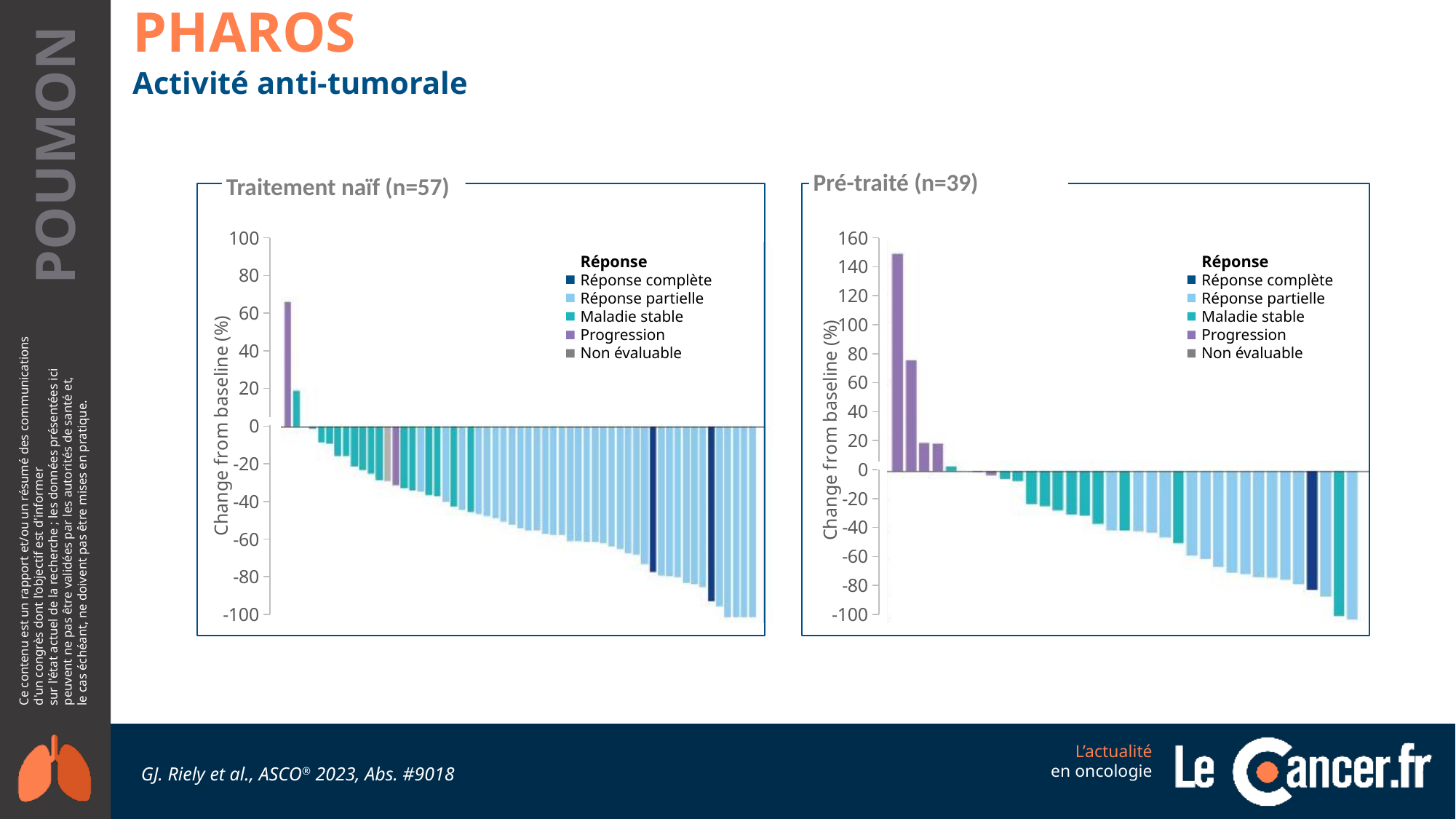
In the 'Traitement naïf (n=57)' chart, what is the label of the y axis? Change from baseline (%) In the 'Traitement naïf (n=57)' chart, is the value of the lowest bar greater or less than -80? less In the 'Pré-traité (n=39)' chart, is the value of the second tallest positive bar greater or less than 60? greater In the 'Pré-traité (n=39)' chart, which legend entry is shown in purple? Progression In the 'Traitement naïf (n=57)' chart, is the value of the tallest positive bar greater or less than 60? greater Do the bar values in the 'Pré-traité (n=39)' chart rise or fall from left to right along the x axis? fall What kind of chart is shown under the title 'Traitement naïf (n=57)'? bar chart Which chart has the higher maximum change from baseline, 'Traitement naïf (n=57)' or 'Pré-traité (n=39)'? Pré-traité (n=39) According to its title, how many patients are plotted in the 'Traitement naïf' chart? 57 How many response categories does the legend of the 'Pré-traité (n=39)' chart list? 5 According to its title, how many patients are plotted in the 'Pré-traité' chart? 39